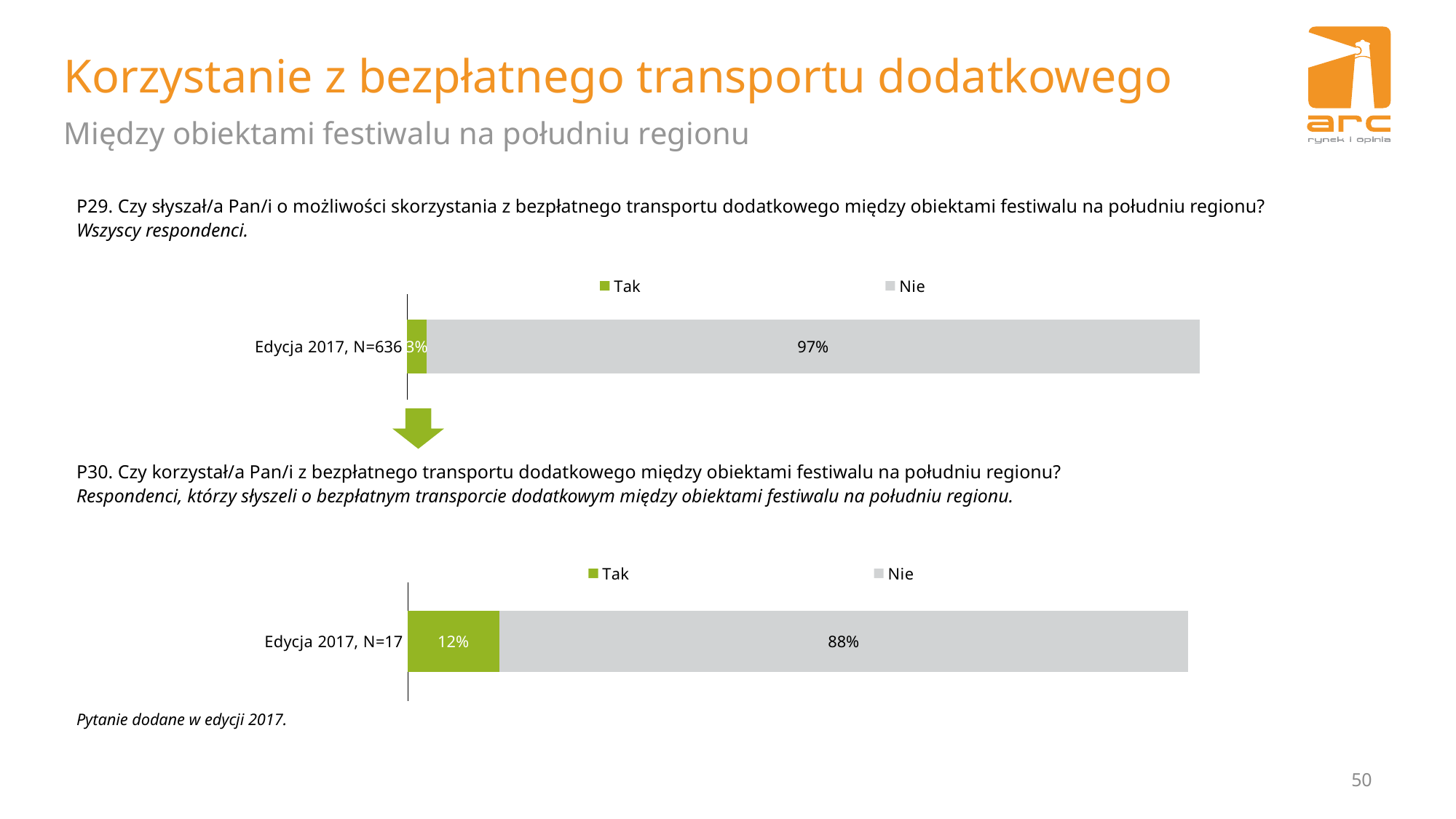
In the bottom chart (P30), what is the value for Tak? 12% In the bottom chart (P30), what is the difference between the Nie and Tak values? 76 percentage points In the top chart (P29), what is the difference between the Nie and Tak values? 94 percentage points In the bottom chart (P30), which series has the larger value, Tak or Nie? Nie In the top chart (P29), what is the value for Nie? 97% In the bottom chart (P30), what colour represents the Tak series? Green In the top chart (P29), what is the value for Tak? 3% How many series does the legend of the top chart (P29) list? 2 What is the category label of the bar in the top chart (P29)? Edycja 2017, N=636 What kind of chart is the bottom chart (P30)? Stacked bar chart In the bottom chart (P30), what is the total of the stacked bar for Edycja 2017, N=17? 100% In the bottom chart (P30), what is the value for Nie? 88%